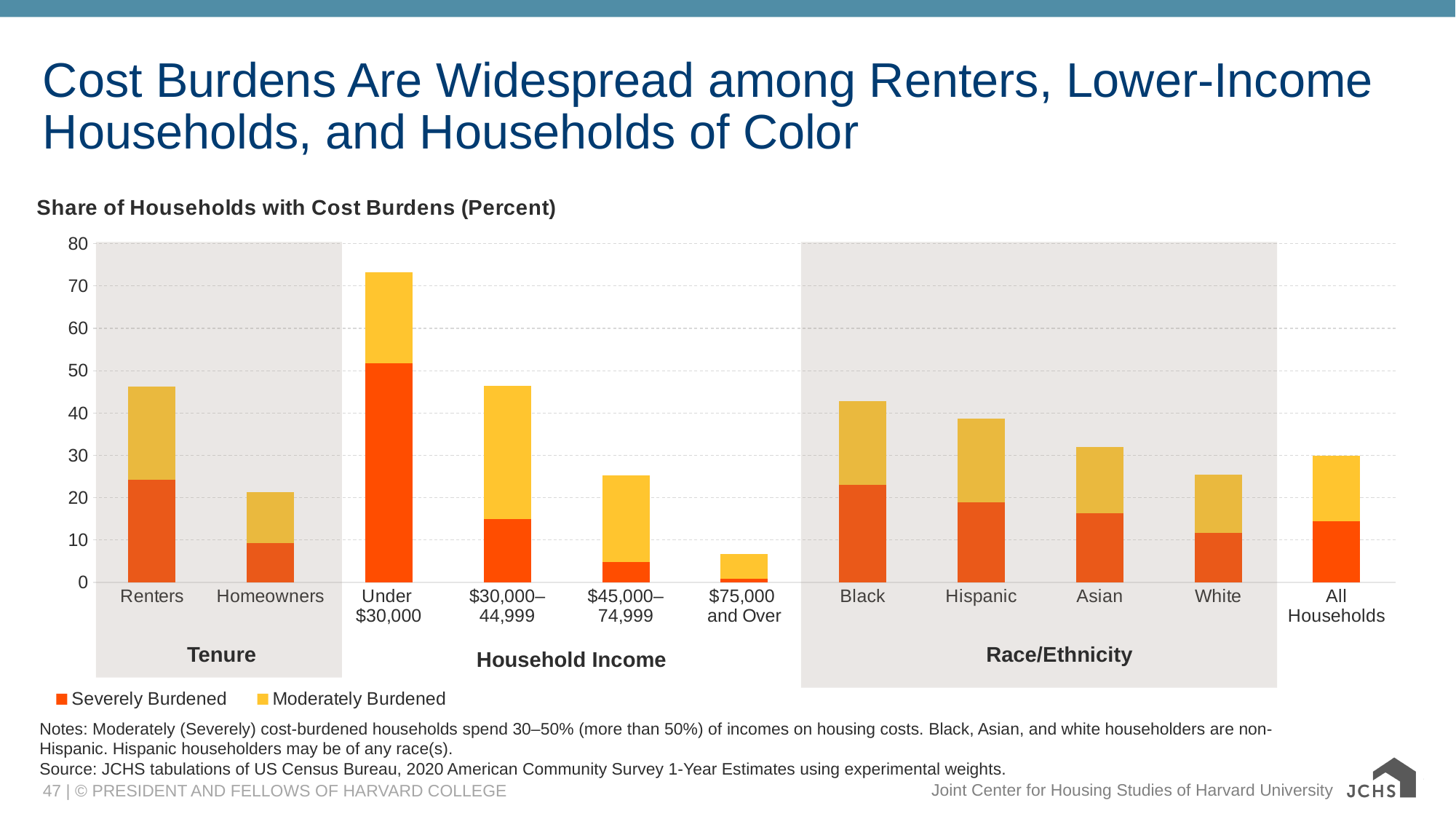
How many categories are plotted along the x axis? 11 Which series is shown in the darker orange colour at the bottom of each bar? Severely Burdened Is the total value for Under $30,000 greater or less than 70? greater Which category has the highest total share of households with cost burdens? Under $30,000 Which category has the lowest total share of households with cost burdens? $75,000 and Over How many series does the legend list? 2 Is the total value for White greater or less than 30? less Is the total value for Renters greater or less than 40? greater What kind of chart is shown on the slide? Stacked bar chart Which has a larger total share of cost-burdened households, Renters or Homeowners? Renters Which has a larger total share of cost-burdened households, Black or Hispanic? Black